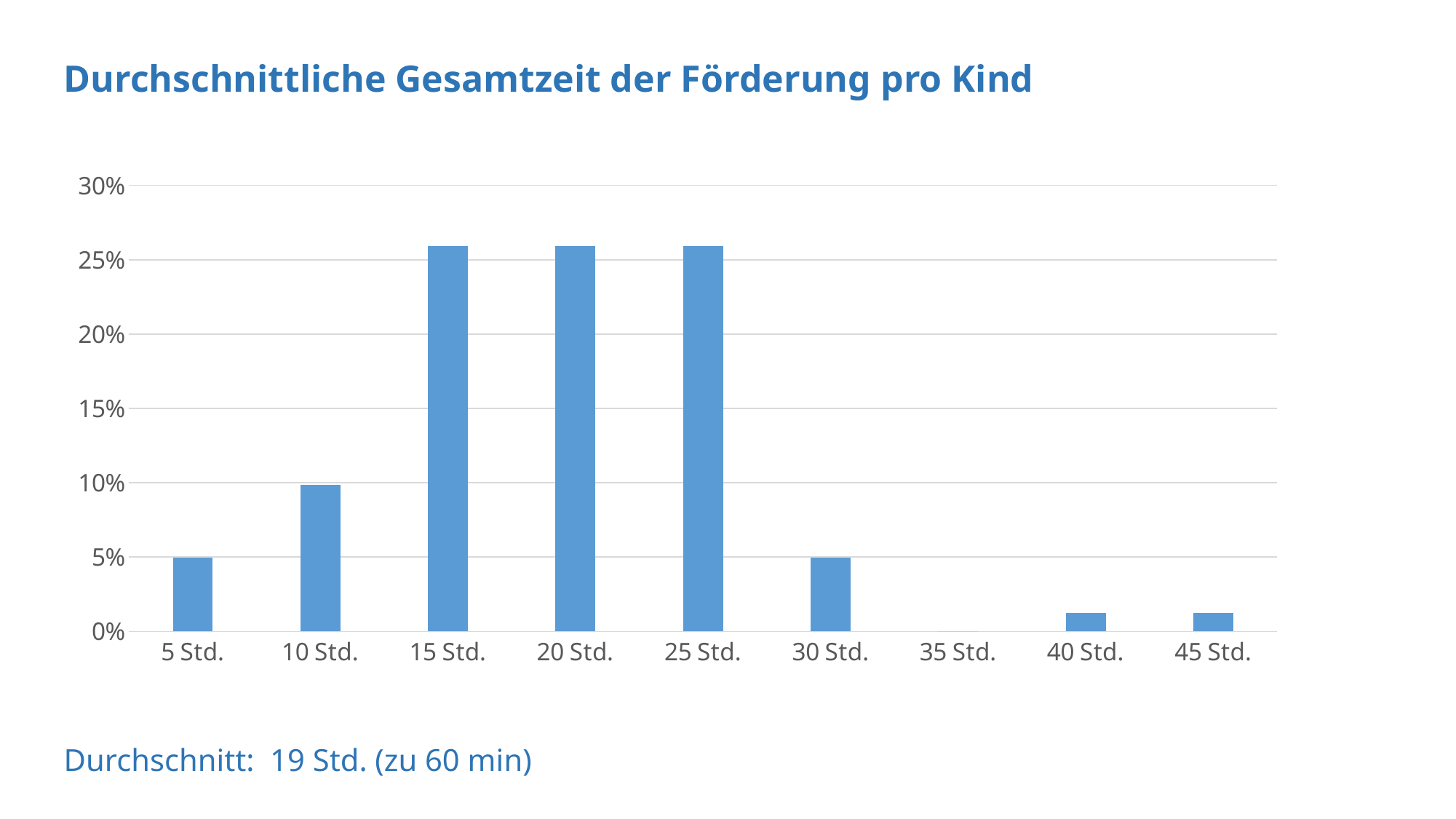
Do the values rise or fall from 5 Std. to 15 Std.? rise What kind of chart is shown on the slide? bar chart Is the value for 40 Std. greater or less than 5%? less How many categories are shown on the x axis? 9 Is the value for 15 Std. greater or less than 25%? greater Is the value for 20 Std. greater or less than 20%? greater What average (Durchschnitt) is stated below the chart? 19 Std. (zu 60 min) Which category has the lowest value? 35 Std. Which is larger, the value for 10 Std. or the value for 5 Std.? 10 Std. Which is larger, the value for 25 Std. or the value for 30 Std.? 25 Std. What is the title of the chart? Durchschnittliche Gesamtzeit der Förderung pro Kind